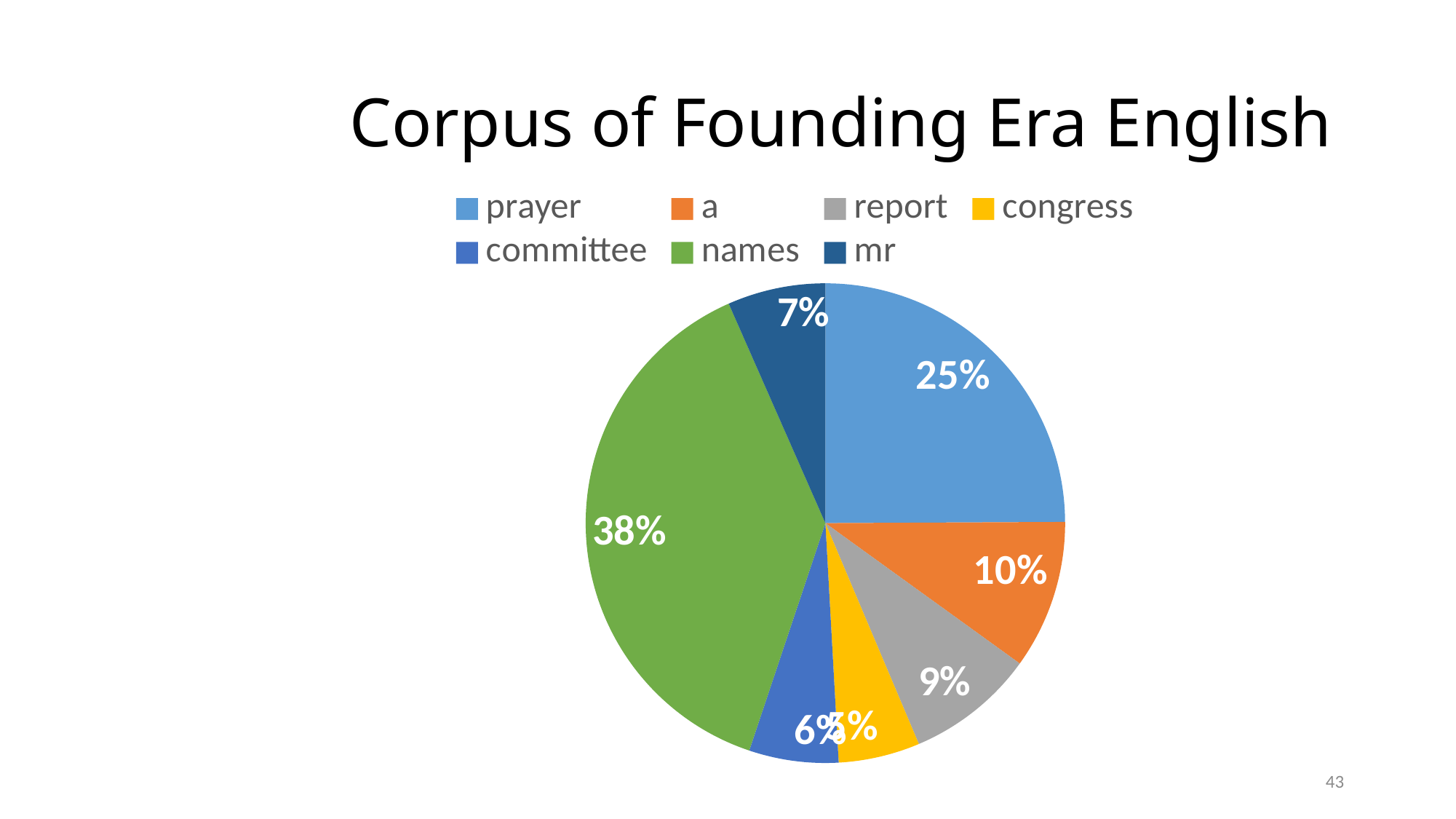
Which has a larger share, "prayer" or "a"? prayer What colour is the "names" slice in the pie chart? green What is the title of the slide? Corpus of Founding Era English Which category has the largest slice of the pie? names What share of the pie does "a" have? 10% How many percentage points larger is the "names" share than the "prayer" share? 13% What share of the pie does "names" have? 38% How many categories does the pie chart show? 7 What kind of chart is shown on the slide? pie chart What share of the pie does "prayer" have? 25% What share of the pie does "mr" have? 7% What share of the pie does "report" have? 9%